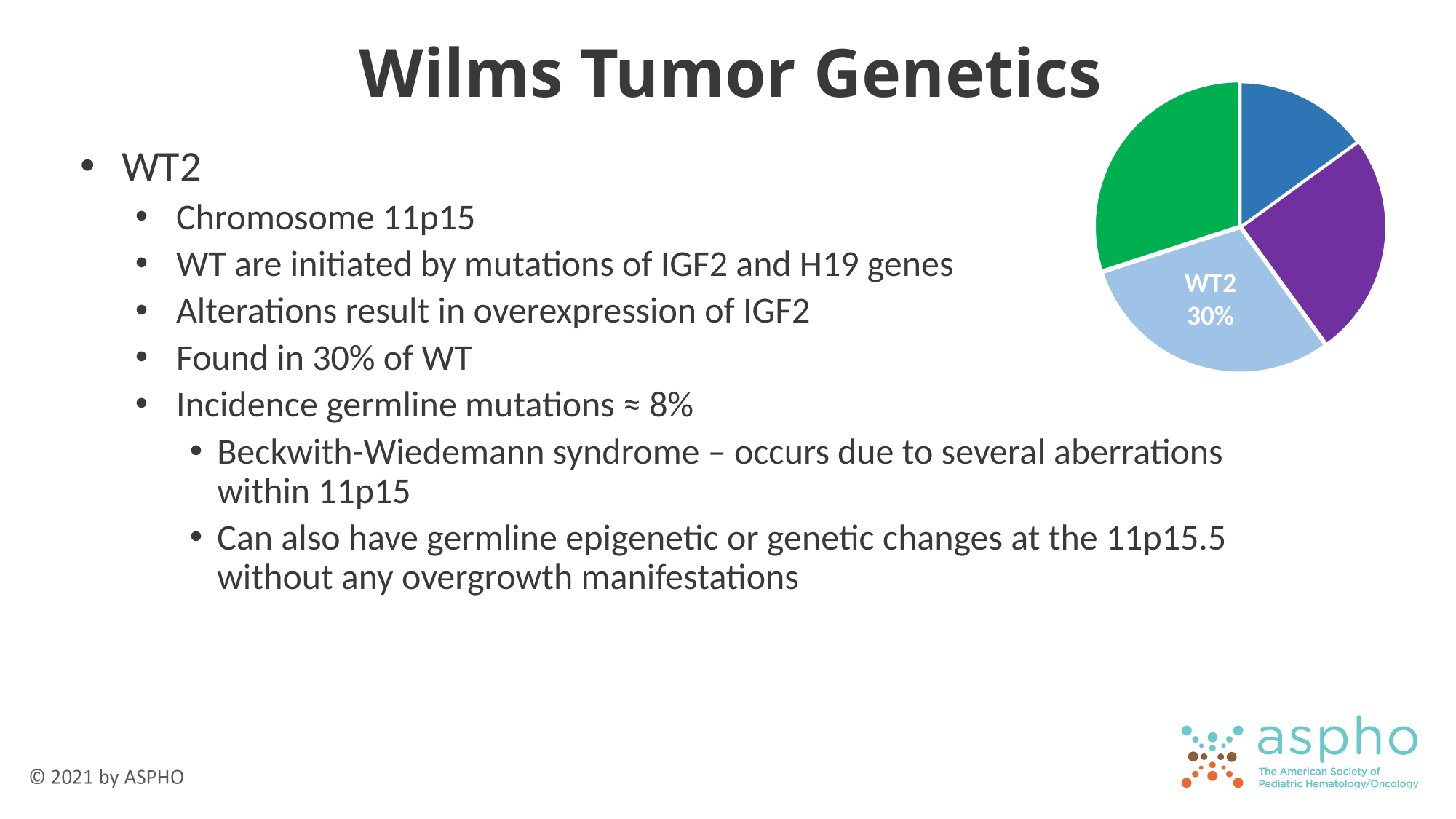
What kind of chart is shown on the slide? pie chart What share of the pie does the WT2 slice represent? 30% What colour is the WT2 slice in the pie chart? light blue Is the value for WT2 in the pie chart greater or less than 50%? less What percentage is shown for the WT2 slice in the pie chart? 30% How many slices does the pie chart have? 4 Which slice of the pie chart is labeled? WT2